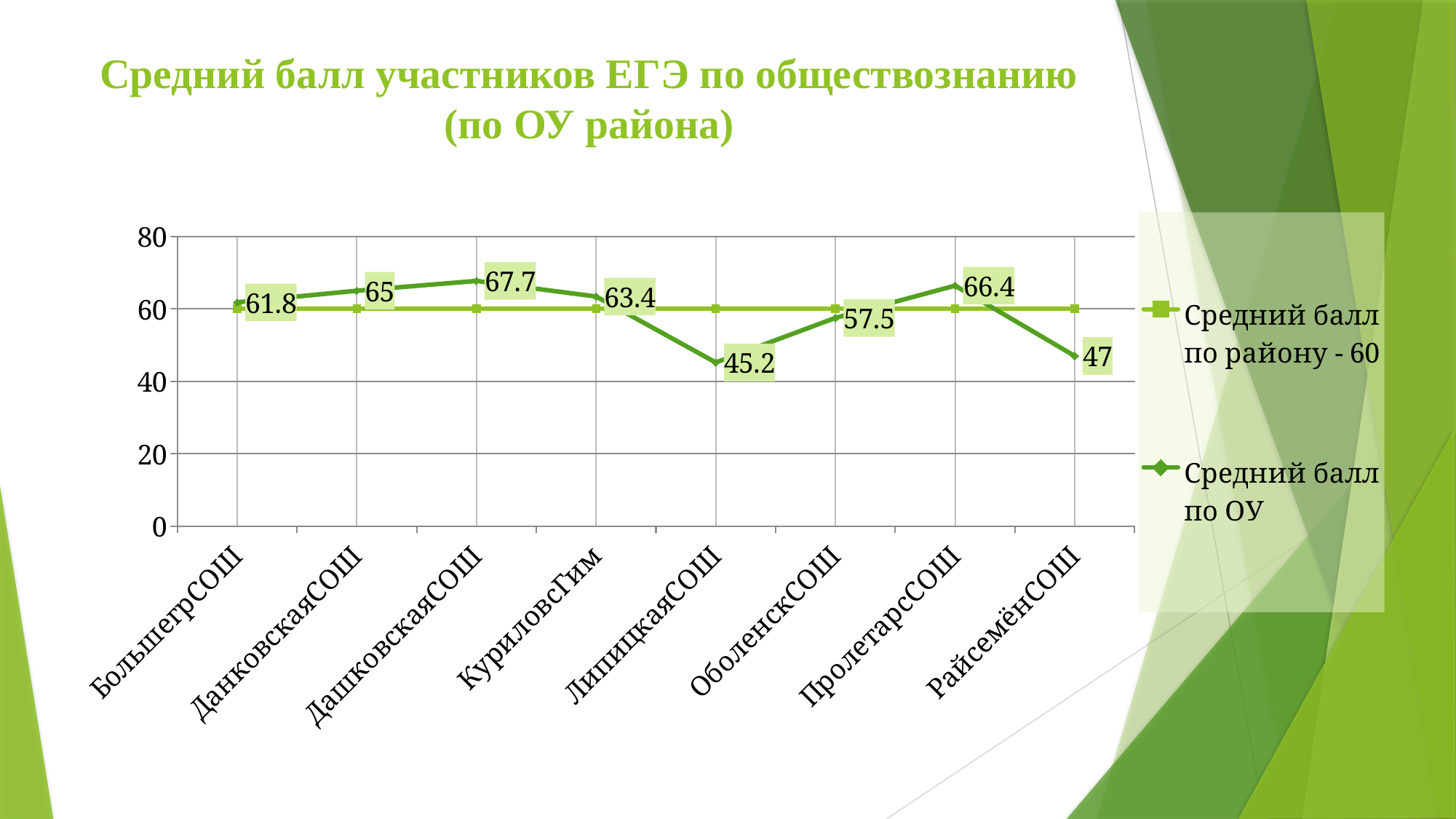
How many schools are shown on the x axis? 8 What is the average score (Средний балл по ОУ) for ЛипицкаяСОШ? 45.2 Which school has the highest average score (Средний балл по ОУ)? ДашковскаяСОШ What is the value of the district average line (Средний балл по району)? 60 Which school has the lowest average score (Средний балл по ОУ)? ЛипицкаяСОШ What is the average score (Средний балл по ОУ) for РайсемёнСОШ? 47 Is the average score for ОболенскСОШ greater or less than 60? less How many series does the legend list? 2 What is the difference between the average scores of ДашковскаяСОШ and ЛипицкаяСОШ? 22.5 Which has a higher average score, ПролетарсСОШ or ОболенскСОШ? ПролетарсСОШ What is the average score (Средний балл по ОУ) for ДашковскаяСОШ? 67.7 What kind of chart is shown on the slide? line chart